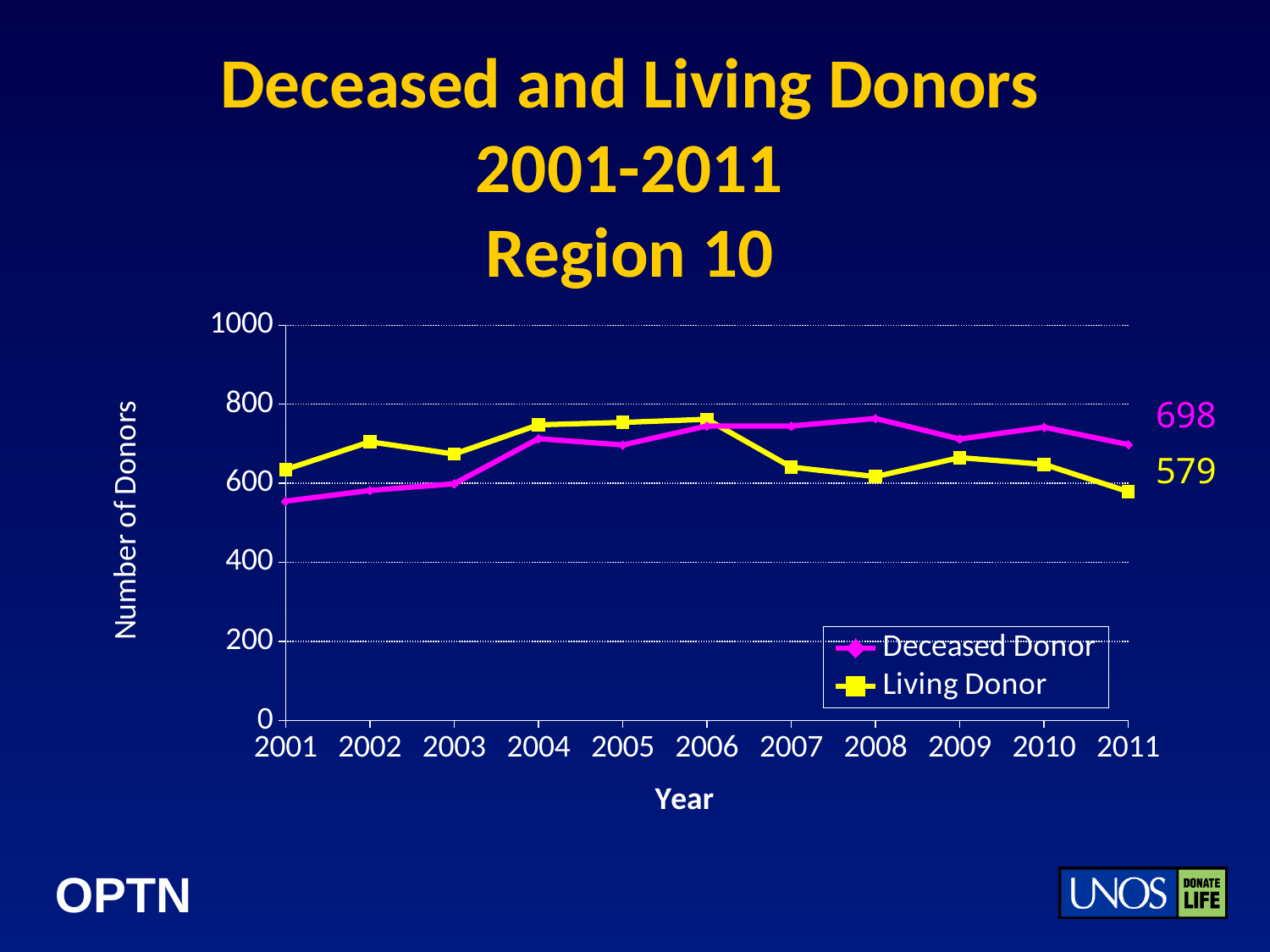
Is the value for Living Donor in 2006 greater or less than 700? greater Is the value for Deceased Donor in 2008 greater or less than 700? greater Is the value for Living Donor in 2007 greater or less than 700? less In 2011, which series has the larger value, Deceased Donor or Living Donor? Deceased Donor What is the value for Deceased Donor in 2011? 698 How many series does the legend list? 2 What is the value for Living Donor in 2011? 579 What is the difference between the Deceased Donor and Living Donor values in 2011? 119 What kind of chart is shown on the slide? Line chart How many years are shown on the x axis? 11 Does the Living Donor series rise or fall from 2006 to 2011? Fall